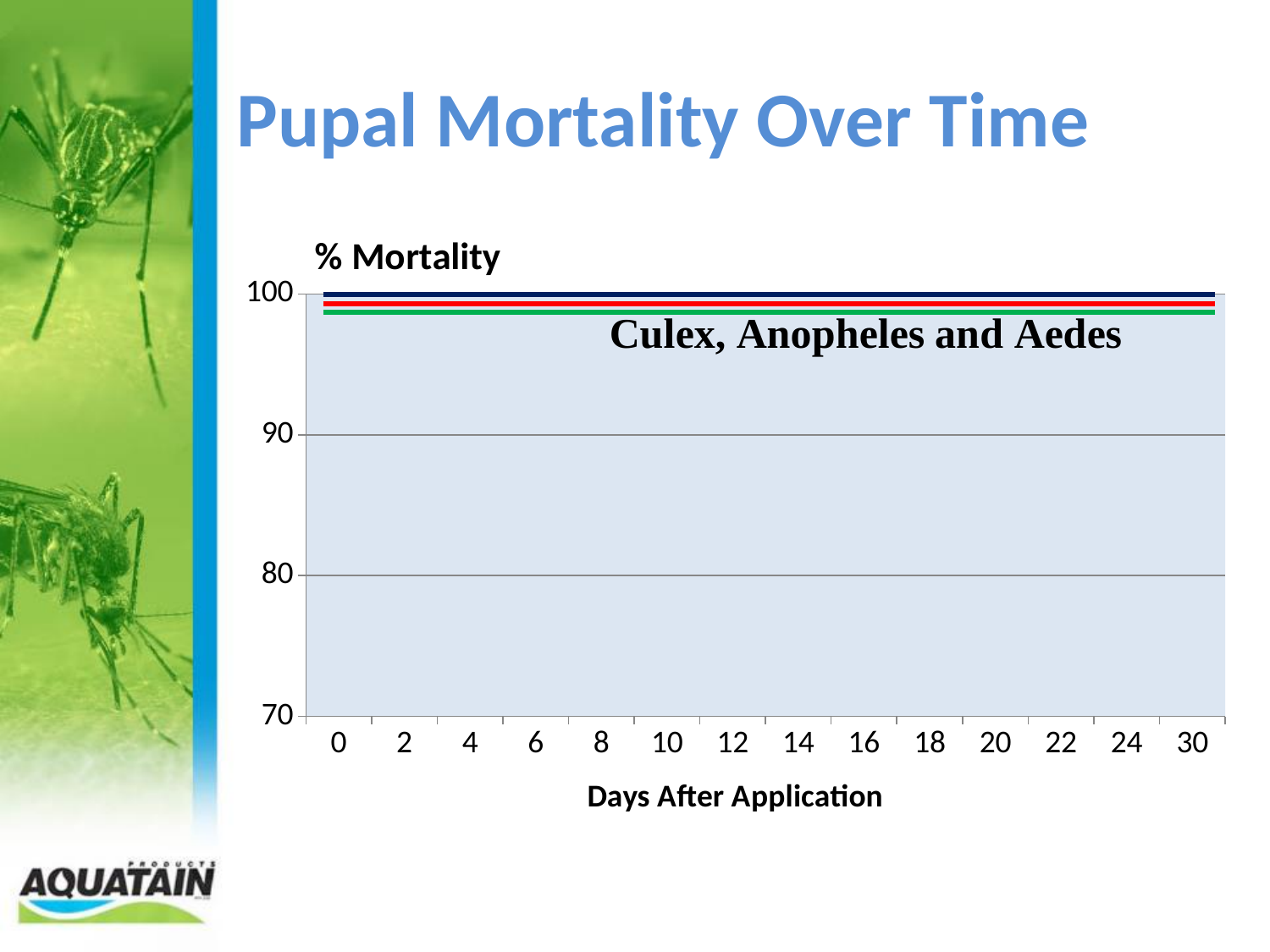
What is the label on the x axis of the chart? Days After Application Is the mortality value at day 16 greater or less than 90? greater What kind of chart is shown on the slide? line chart Is the mortality value at day 30 greater or less than 90? greater How many tick labels are shown along the x axis of the chart? 14 Do the plotted mortality values rise, fall, or stay flat as days after application increase? stay flat How many lines are plotted on the chart? 3 What is the title of the slide's chart? % Mortality What is the highest tick label shown on the x axis of the chart? 30 Is the mortality value at day 0 greater or less than 80? greater